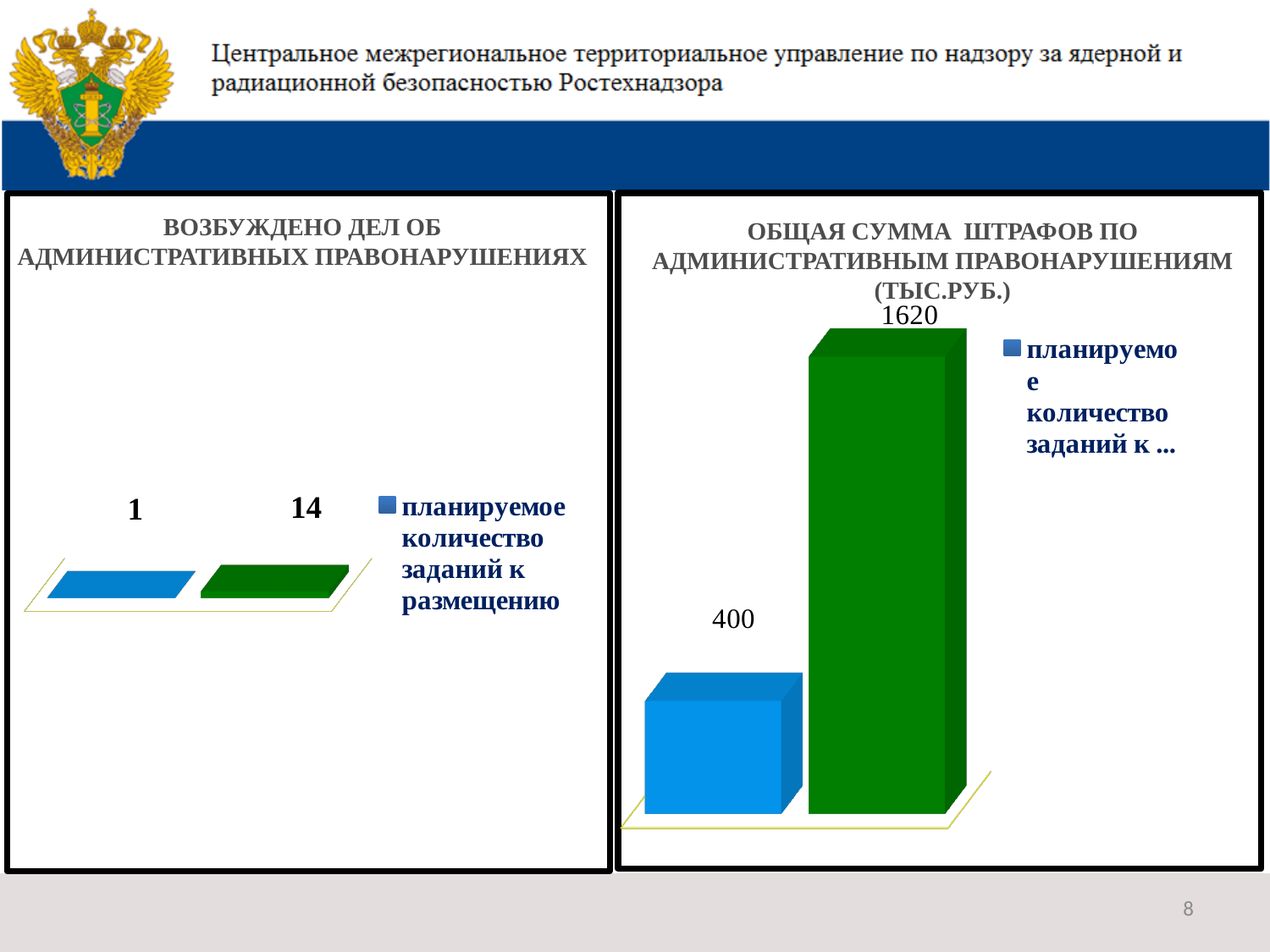
On the right chart 'ОБЩАЯ СУММА ШТРАФОВ ПО АДМИНИСТРАТИВНЫМ ПРАВОНАРУШЕНИЯМ (ТЫС.РУБ.)', what value is shown on the green bar? 1620 On the left chart, what is the legend entry text? планируемое количество заданий к размещению On the right chart 'ОБЩАЯ СУММА ШТРАФОВ ПО АДМИНИСТРАТИВНЫМ ПРАВОНАРУШЕНИЯМ (ТЫС.РУБ.)', what is the difference between the green bar and the blue bar? 1220 On the left chart 'ВОЗБУЖДЕНО ДЕЛ ОБ АДМИНИСТРАТИВНЫХ ПРАВОНАРУШЕНИЯХ', what is the difference between the green bar and the blue bar? 13 On the left chart 'ВОЗБУЖДЕНО ДЕЛ ОБ АДМИНИСТРАТИВНЫХ ПРАВОНАРУШЕНИЯХ', what value is shown on the green bar? 14 On the right chart 'ОБЩАЯ СУММА ШТРАФОВ ПО АДМИНИСТРАТИВНЫМ ПРАВОНАРУШЕНИЯМ (ТЫС.РУБ.)', what value is shown on the blue bar? 400 On the right chart 'ОБЩАЯ СУММА ШТРАФОВ ПО АДМИНИСТРАТИВНЫМ ПРАВОНАРУШЕНИЯМ (ТЫС.РУБ.)', which bar is the highest? the green bar (1620) On the left chart 'ВОЗБУЖДЕНО ДЕЛ ОБ АДМИНИСТРАТИВНЫХ ПРАВОНАРУШЕНИЯХ', what value is shown on the blue bar? 1 On the right chart 'ОБЩАЯ СУММА ШТРАФОВ ПО АДМИНИСТРАТИВНЫМ ПРАВОНАРУШЕНИЯМ (ТЫС.РУБ.)', how many entries does the legend list? 1 On the left chart 'ВОЗБУЖДЕНО ДЕЛ ОБ АДМИНИСТРАТИВНЫХ ПРАВОНАРУШЕНИЯХ', how many bars are plotted? 2 On the right chart 'ОБЩАЯ СУММА ШТРАФОВ ПО АДМИНИСТРАТИВНЫМ ПРАВОНАРУШЕНИЯМ (ТЫС.РУБ.)', which is larger, the blue bar or the green bar? the green bar On the left chart 'ВОЗБУЖДЕНО ДЕЛ ОБ АДМИНИСТРАТИВНЫХ ПРАВОНАРУШЕНИЯХ', what kind of chart is shown? bar chart